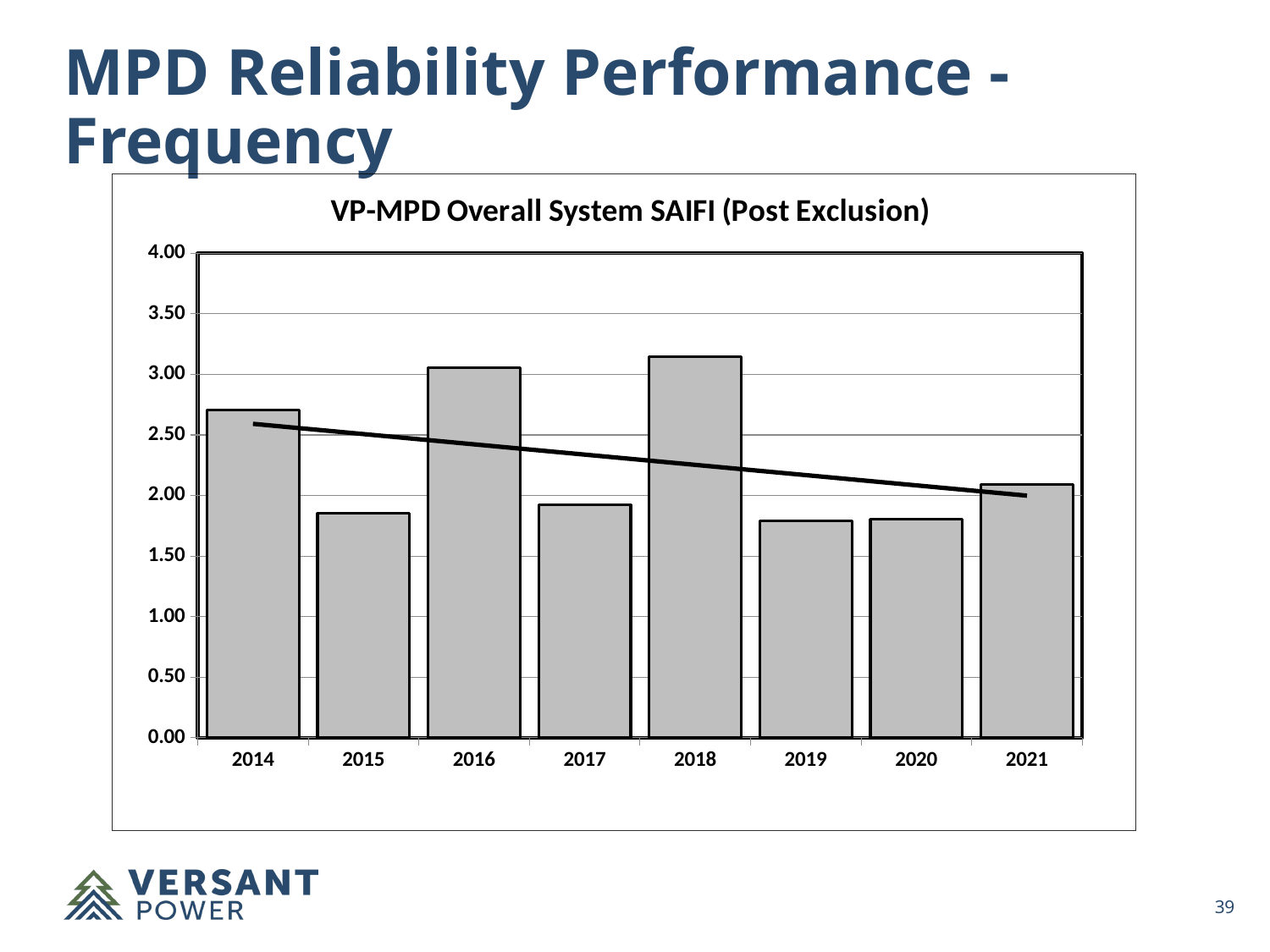
Which year has the highest SAIFI value? 2018 What is the title of the chart? VP-MPD Overall System SAIFI (Post Exclusion) What kind of chart is shown on the slide? bar chart Is the value for 2015 greater or less than 2.00? less Which year has the larger value, 2014 or 2015? 2014 Is the value for 2021 greater or less than 2.00? greater How many years are shown on the x axis of the chart? 8 Is the value for 2014 greater or less than 2.50? greater Does the trend line drawn across the bars rise or fall from 2014 to 2021? fall Which year has the larger value, 2016 or 2017? 2016